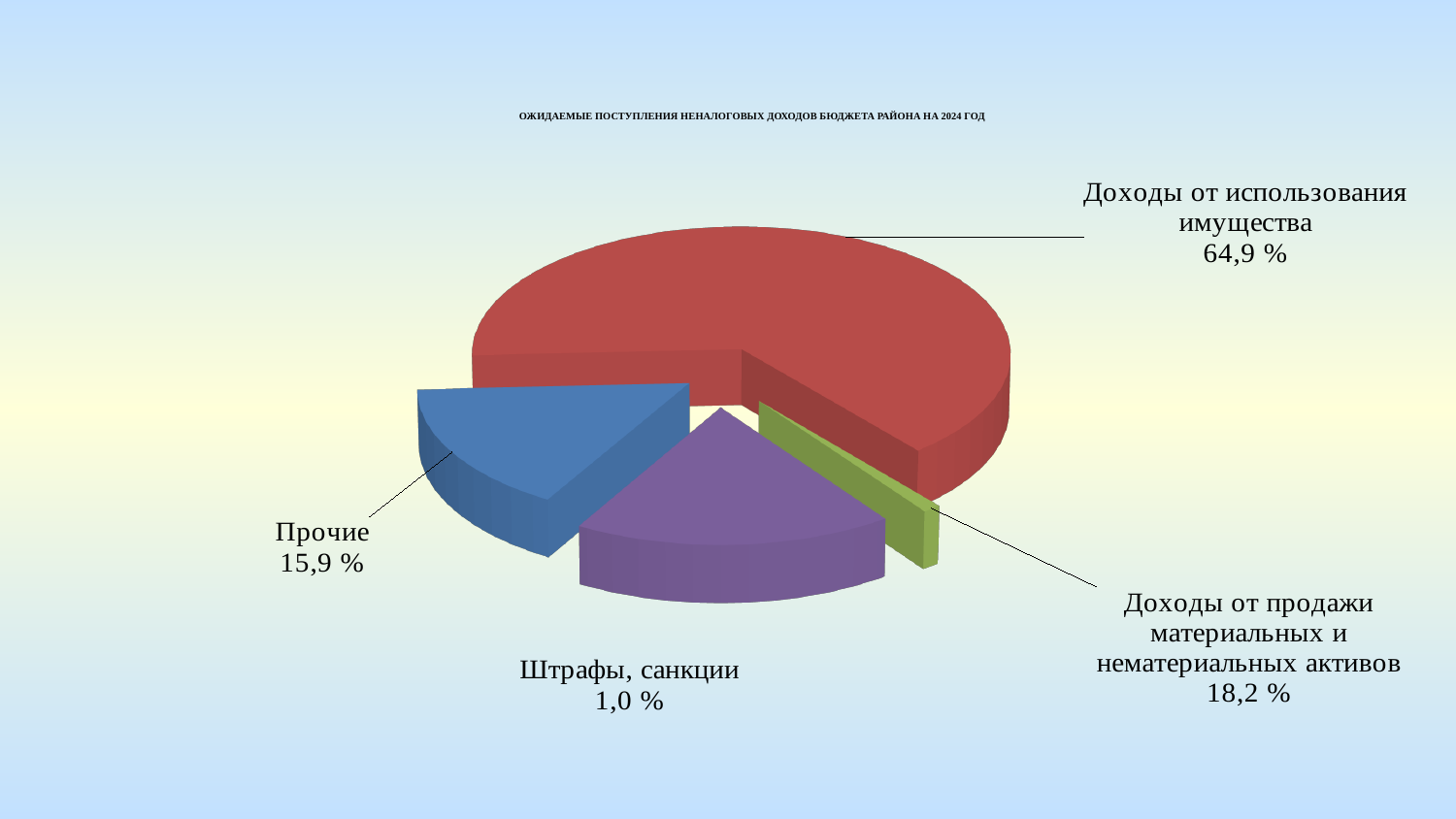
Which is larger: the share for Прочие or the share for Доходы от продажи материальных и нематериальных активов? Доходы от продажи материальных и нематериальных активов What is the difference in percentage points between Доходы от использования имущества and Доходы от продажи материальных и нематериальных активов? 46,7 What percentage is shown for Доходы от продажи материальных и нематериальных активов? 18,2 % What is the title of the chart? ОЖИДАЕМЫЕ ПОСТУПЛЕНИЯ НЕНАЛОГОВЫХ ДОХОДОВ БЮДЖЕТА РАЙОНА НА 2024 ГОД What percentage is shown for Штрафы, санкции? 1,0 % What kind of chart is shown on the slide? Pie chart Which category has the largest share of the pie? Доходы от использования имущества What colour is the slice for Доходы от использования имущества? Red What share of the pie is labelled for Доходы от использования имущества? 64,9 % How many categories (slices) does the pie chart have? 4 What percentage is shown for Прочие? 15,9 % Which category has the smallest labelled percentage? Штрафы, санкции